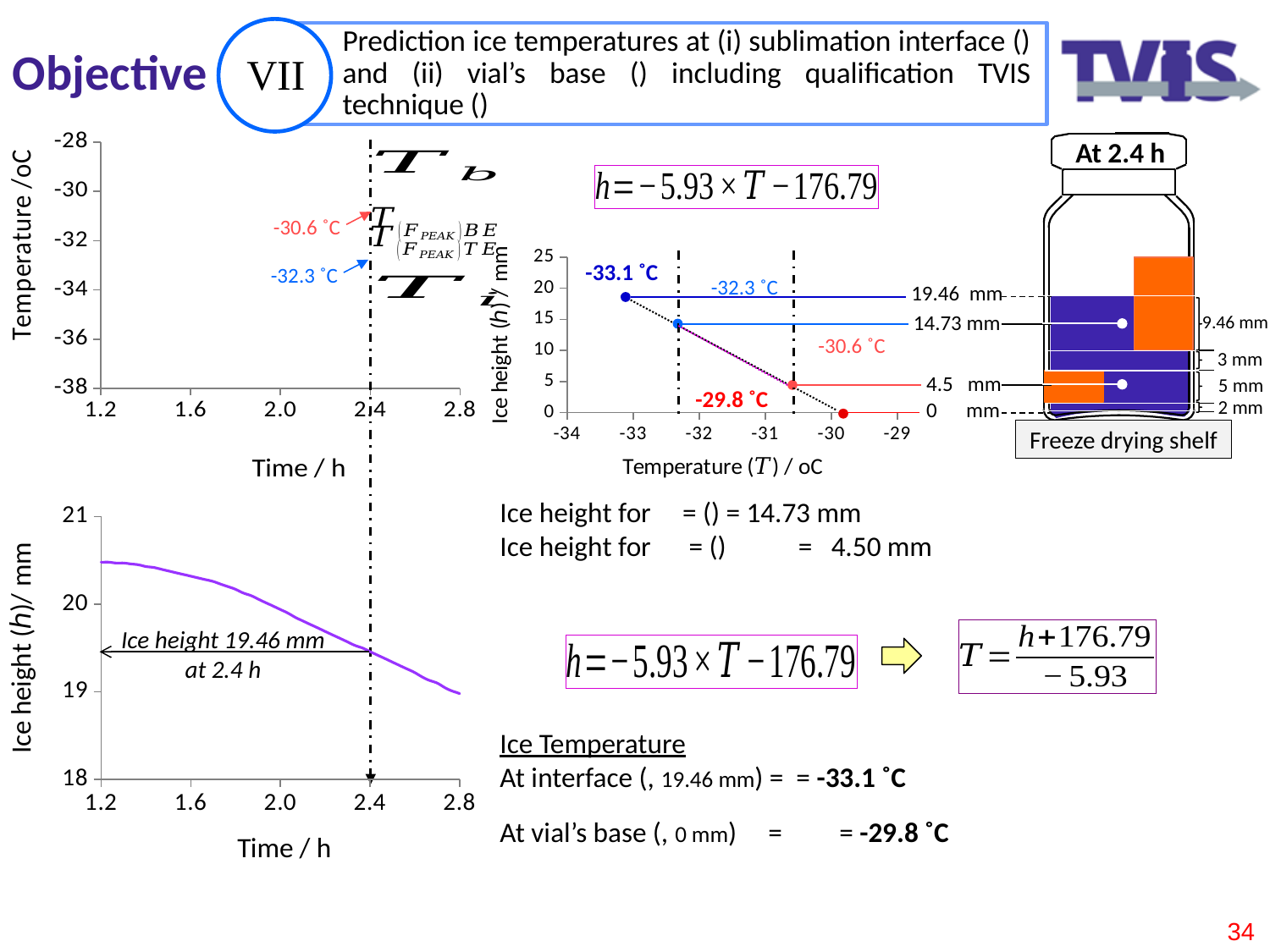
In the middle chart of ice height versus temperature, what is the label of the x axis? Temperature (T) / oC In the bottom-left chart of ice height versus time, does the ice height rise or fall as time increases? fall In the middle chart of ice height versus temperature, how many data points are plotted? 4 In the middle chart of ice height versus temperature, what is the difference between the ice heights at -32.3 °C and -30.6 °C? 10.23 mm In the middle chart of ice height versus temperature, what is the ice height at -32.3 °C? 14.73 mm In the bottom-left chart of ice height versus time, is the ice height at 1.2 h greater or less than 20 mm? greater In the middle chart of ice height versus temperature, at which temperature is the ice height highest? -33.1 °C In the middle chart of ice height versus temperature, what is the ice height at -33.1 °C? 19.46 mm In the middle chart of ice height versus temperature, what is the ice height at -29.8 °C? 0 mm What kind of chart is the bottom-left chart of ice height versus time? line chart In the middle chart of ice height versus temperature, what is the ice height at -30.6 °C? 4.5 mm In the bottom-left chart of ice height versus time, what is the ice height at 2.4 h? 19.46 mm